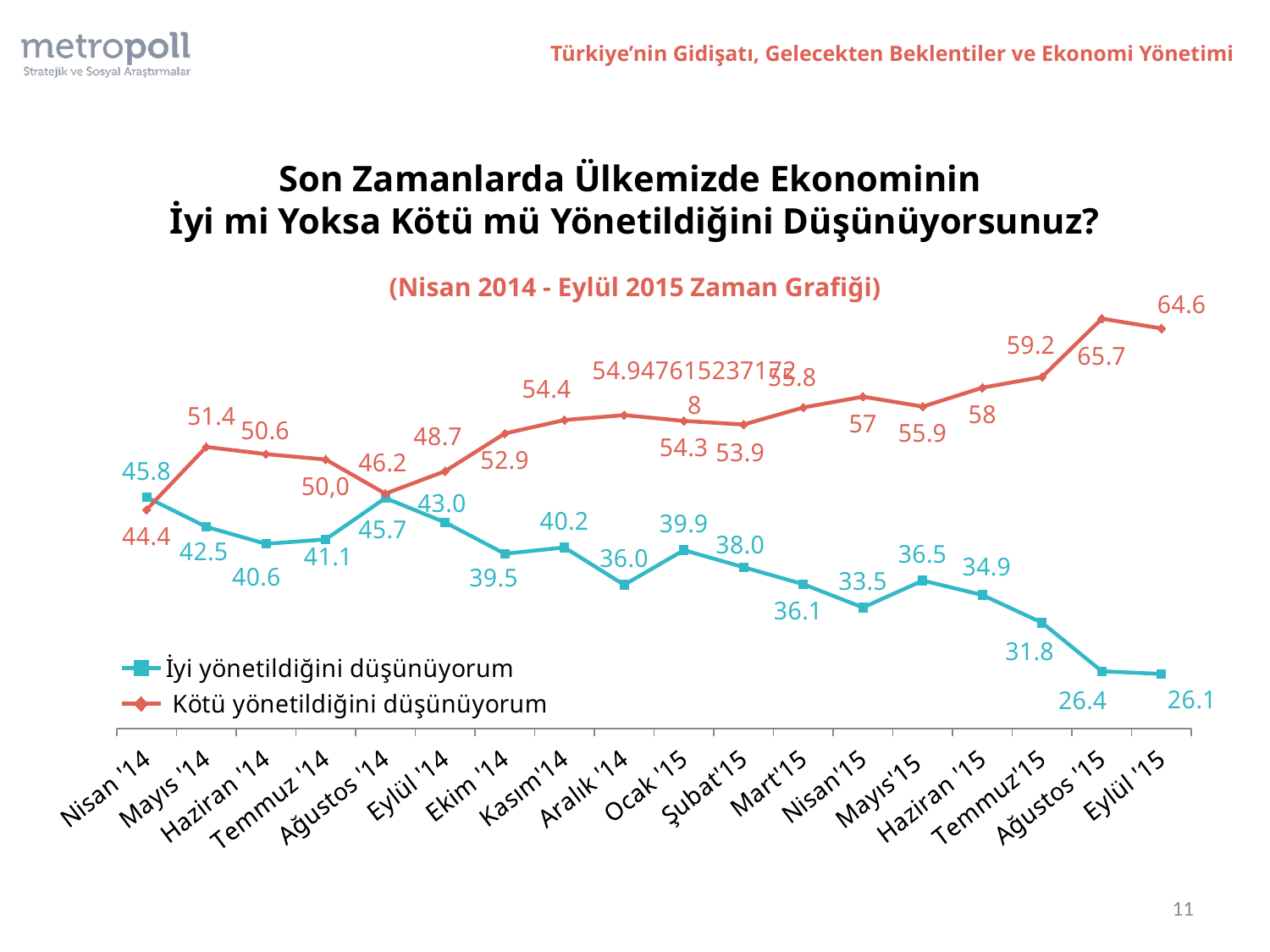
In which month is 'Kötü yönetildiğini düşünüyorum' at its lowest value? Nisan '14 What is the value for 'Kötü yönetildiğini düşünüyorum' in Eylül '15? 64.6 What is the difference between 'Kötü yönetildiğini düşünüyorum' and 'İyi yönetildiğini düşünüyorum' in Eylül '15? 38.5 What is the value for 'İyi yönetildiğini düşünüyorum' in Ağustos '15? 26.4 In which month is 'İyi yönetildiğini düşünüyorum' at its lowest value? Eylül '15 Which series has the higher value in Nisan '14? İyi yönetildiğini düşünüyorum What is the value for 'Kötü yönetildiğini düşünüyorum' in Mayıs '14? 51.4 In which month does 'Kötü yönetildiğini düşünüyorum' reach its highest value? Ağustos '15 What type of chart is shown on the slide? Line chart How many series does the legend list? 2 Does 'İyi yönetildiğini düşünüyorum' generally rise or fall from Nisan '14 to Eylül '15? Fall How many time points are plotted along the x axis? 18